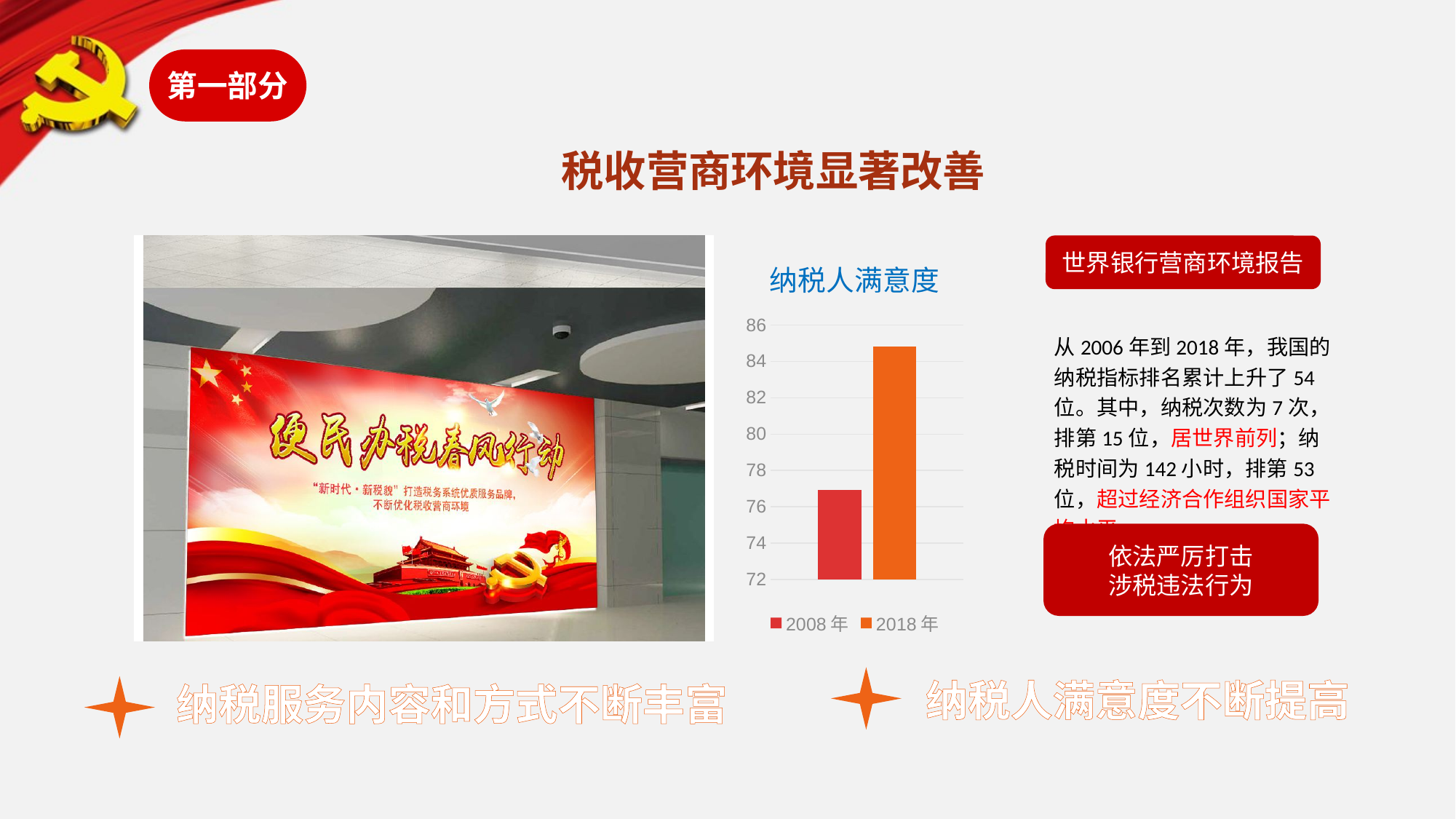
What are the two series named in the legend of the 纳税人满意度 chart? 2008 年 and 2018 年 Which series has the highest bar in the 纳税人满意度 chart? 2018 年 Does taxpayer satisfaction rise or fall from 2008 年 to 2018 年 in the 纳税人满意度 chart? rise What kind of chart is shown under the title 纳税人满意度? bar chart Is the value for 2008 年 in the 纳税人满意度 chart greater or less than 78? less Which series has the lowest bar in the 纳税人满意度 chart? 2008 年 Which series has the higher value in the 纳税人满意度 chart, 2008 年 or 2018 年? 2018 年 What is the title of the chart on the slide? 纳税人满意度 Is the value for 2008 年 in the 纳税人满意度 chart greater or less than 76? greater How many series does the legend of the 纳税人满意度 chart list? 2 Is the value for 2018 年 in the 纳税人满意度 chart greater or less than 84? greater